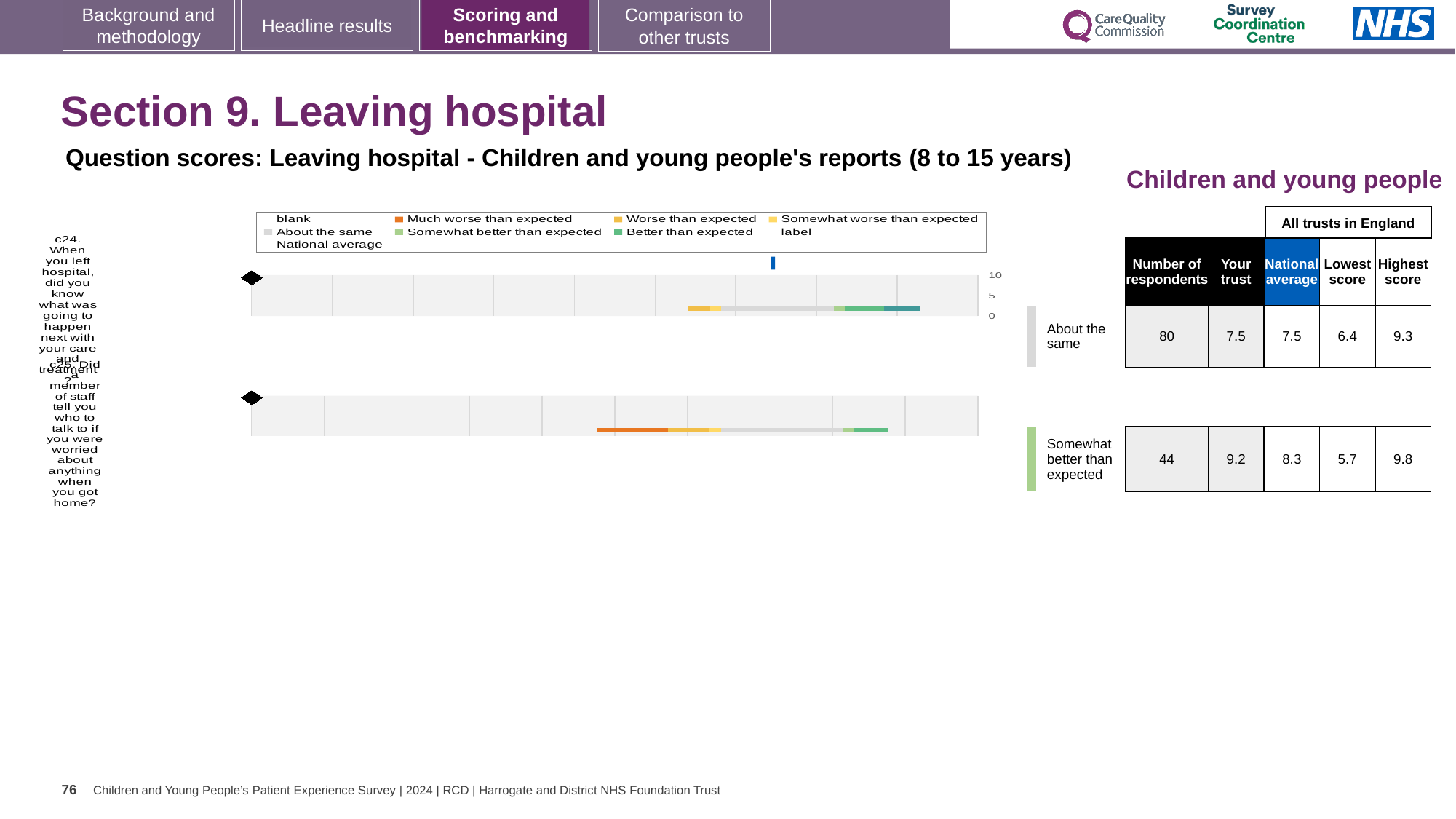
Which question has the higher 'Your trust' score, c24 or c25? c25 What is the difference in the number of respondents between question c24 and question c25? 36 According to the table beside the chart, what is the 'Your trust' score for question c24? 7.5 What is the difference between the 'Your trust' score and the national average for question c25? 0.9 According to the table beside the chart, what is the 'Your trust' score for question c25? 9.2 Which benchmark category is question c25 placed in? Somewhat better than expected How many entries does the chart legend list? 9 Which colour does the legend use for 'Much worse than expected'? orange How many survey questions (categories) are plotted in the chart? 2 According to the table beside the chart, how many respondents answered question c24? 80 According to the table beside the chart, what is the national average for question c25? 8.3 What kind of chart is shown on the slide? bar chart